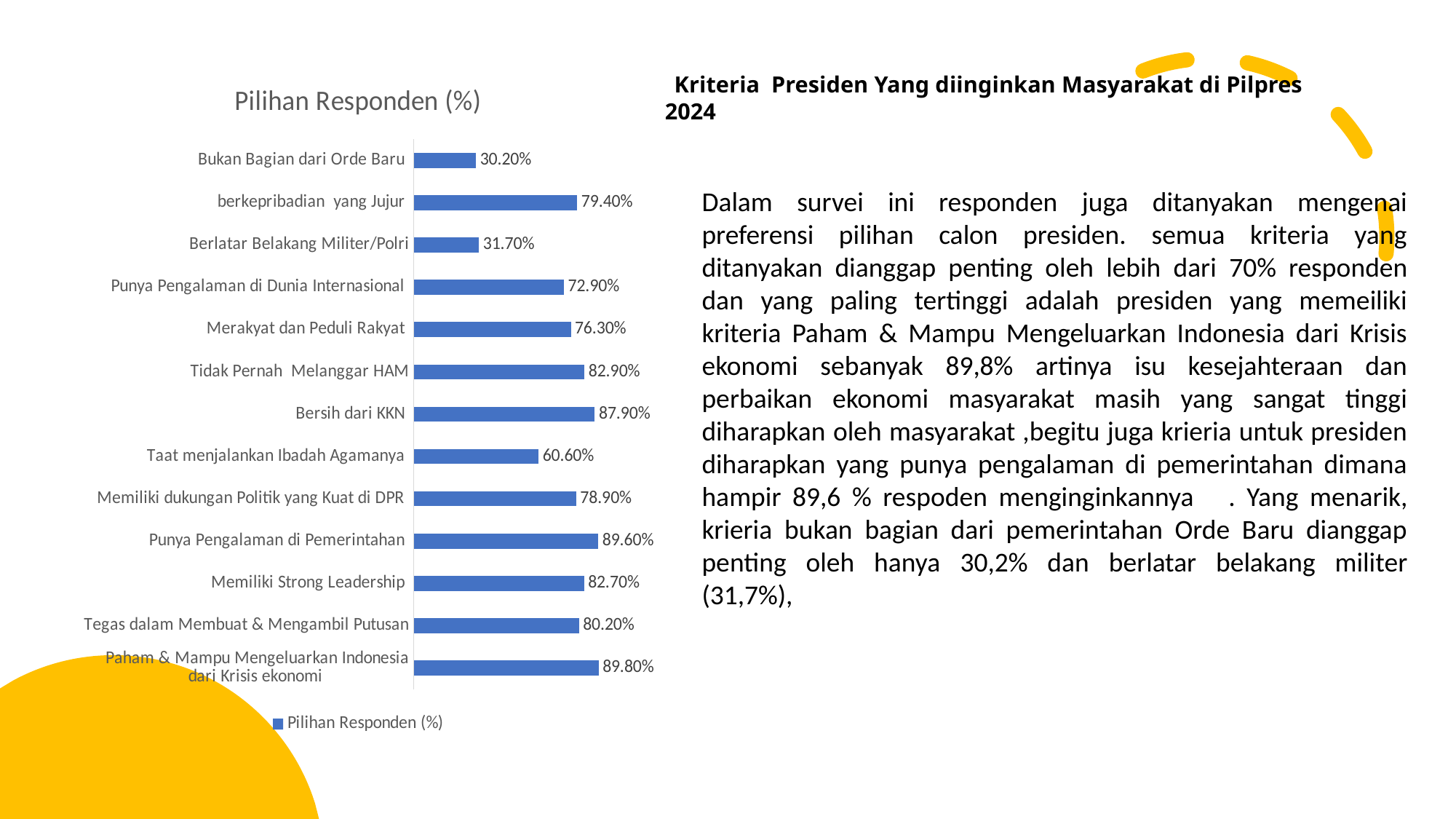
How many categories are shown in the chart? 13 What is the difference between the values for Berlatar Belakang Militer/Polri and Bukan Bagian dari Orde Baru? 1.50% Which category has the highest value in the chart? Paham & Mampu Mengeluarkan Indonesia dari Krisis ekonomi What percentage of respondents chose Bersih dari KKN? 87.90% What is the value for Bukan Bagian dari Orde Baru in the Pilihan Responden (%) chart? 30.20% What is the value for Punya Pengalaman di Pemerintahan? 89.60% What is the value shown for Taat menjalankan Ibadah Agamanya? 60.60% What is the difference between the values for Bersih dari KKN and Taat menjalankan Ibadah Agamanya? 27.30% Which category has the lowest value in the chart? Bukan Bagian dari Orde Baru Which has a larger value: Merakyat dan Peduli Rakyat or Punya Pengalaman di Dunia Internasional? Merakyat dan Peduli Rakyat What type of chart is shown on the slide? Bar chart How many series does the legend list? 1